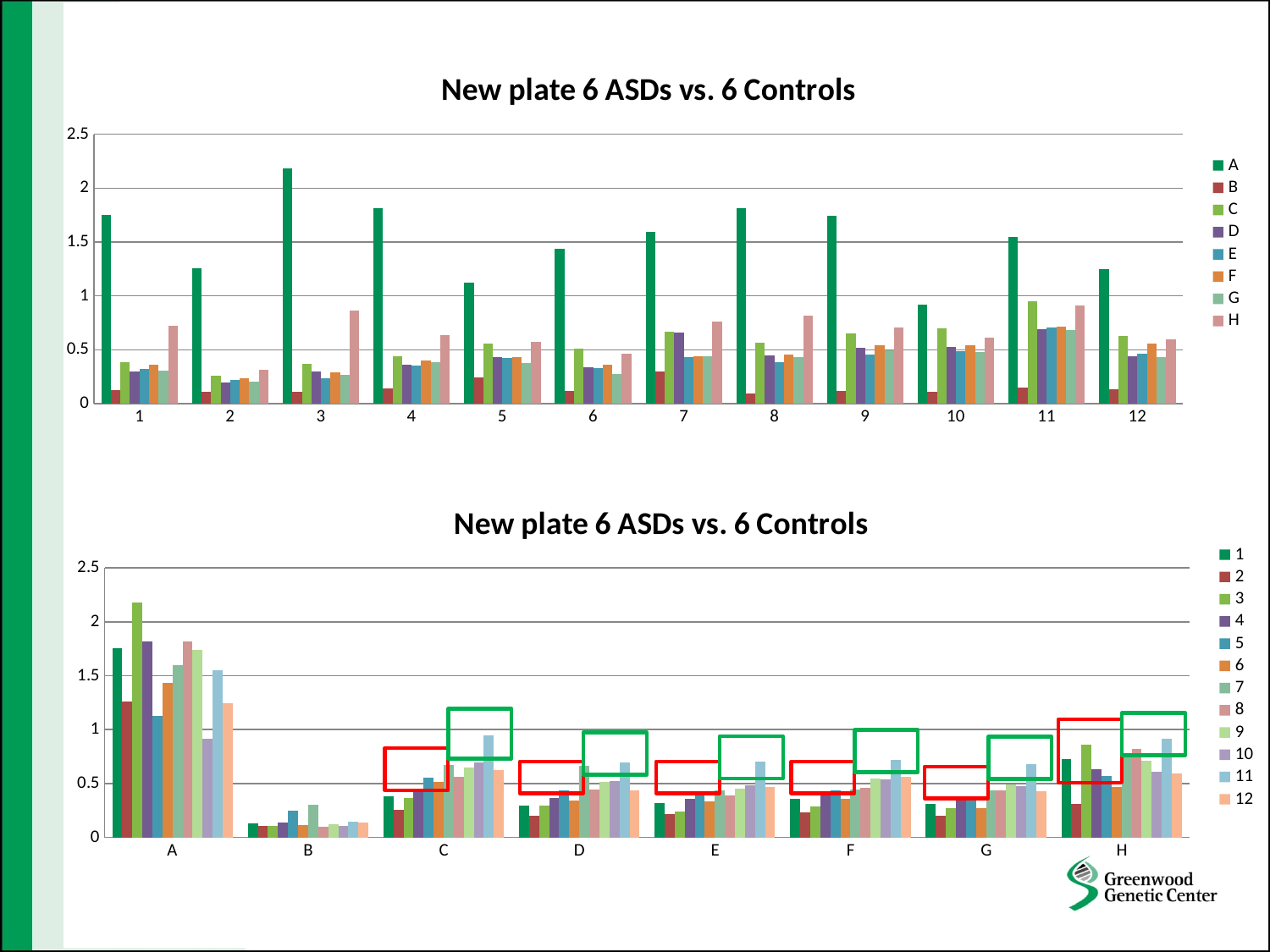
How many series does the legend of the top chart list? 8 In the bottom chart, which category has the tallest bars overall? A In the top chart, in which category does series A reach its highest value? 3 In the top chart, is the value of series A for category 10 greater or less than 1? less In the bottom chart, is the value of series 3 for category A greater or less than 2? greater How many series does the legend of the bottom chart list? 12 How many categories are shown on the x axis of the top chart? 12 How many categories are shown on the x axis of the bottom chart? 8 What type of chart is the top chart on the slide? bar chart In the top chart, which series has the tallest bar in every category? A In the top chart, is the value of series A for category 3 greater or less than 2? greater What is the title of the bottom chart? New plate 6 ASDs vs. 6 Controls